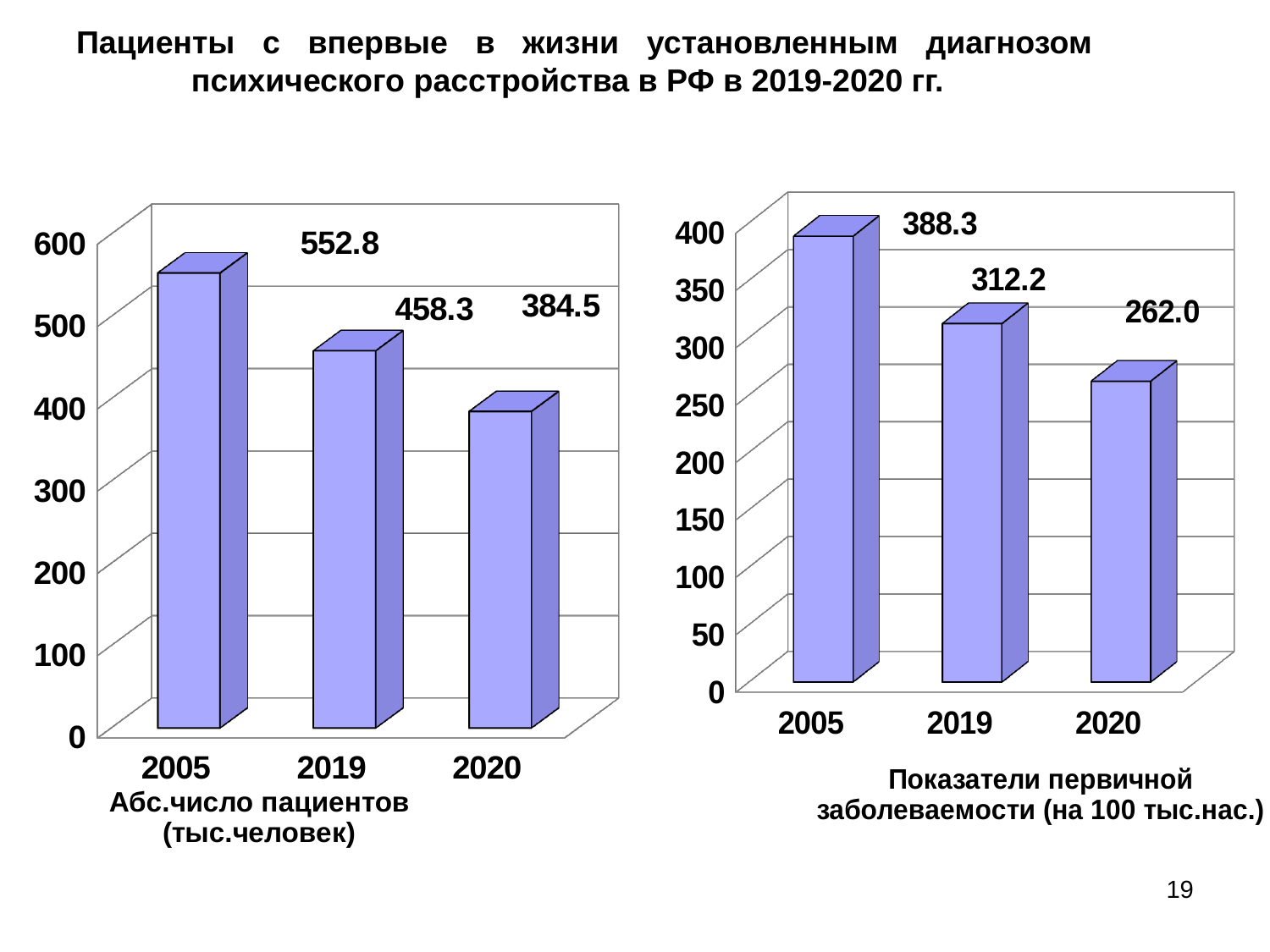
How many bars are in the right chart (Показатели первичной заболеваемости)? 3 In the left chart (Абс.число пациентов), what is the value for 2020? 384.5 In the right chart (Показатели первичной заболеваемости), do the values rise or fall from 2005 to 2020? Fall In the left chart (Абс.число пациентов), what is the difference between the values for 2005 and 2020? 168.3 In the right chart (Показатели первичной заболеваемости), what is the value for 2020? 262.0 In the right chart (Показатели первичной заболеваемости), what is the difference between the values for 2005 and 2019? 76.1 In the left chart (Абс.число пациентов), which is larger: the value for 2019 or the value for 2020? 2019 What type of chart is the left chart (Абс.число пациентов)? Bar chart In the left chart (Абс.число пациентов), what is the value for 2005? 552.8 In the right chart (Показатели первичной заболеваемости), what is the value for 2019? 312.2 In the left chart (Абс.число пациентов), which year has the highest value? 2005 In the right chart (Показатели первичной заболеваемости), which year has the lowest value? 2020